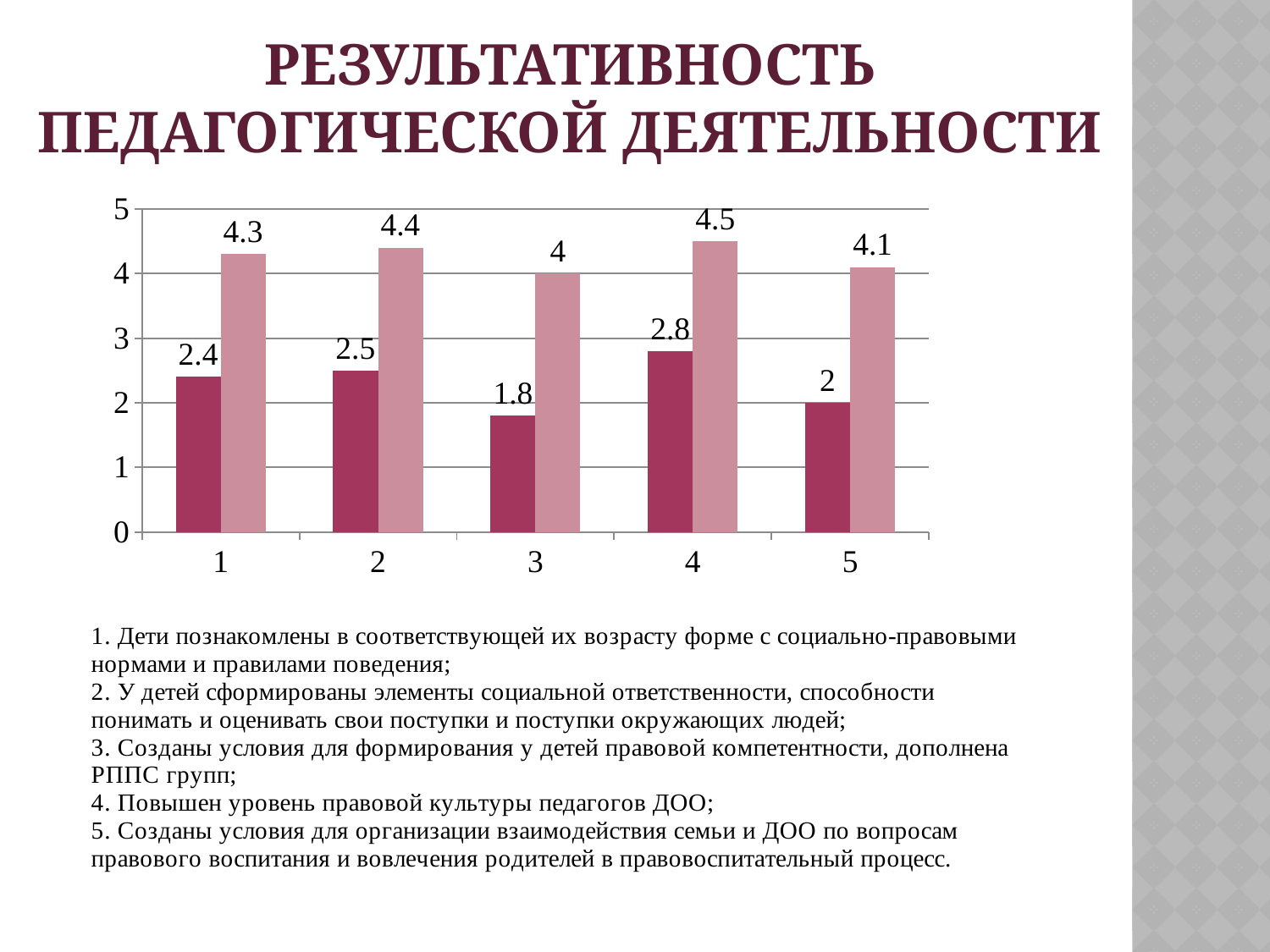
What is the value of the dark magenta bar for category 3? 1.8 Which category has the lowest dark magenta bar? 3 Which is larger: the dark magenta bar for category 2 or the dark magenta bar for category 5? category 2 What is the value of the dark magenta bar for category 5? 2 What kind of chart is shown on the slide? bar chart What is the difference between the dark magenta bars for category 4 and category 3? 1 What is the value of the light pink bar for category 4? 4.5 How many categories are shown on the x axis? 5 What is the title of the slide containing the chart? РЕЗУЛЬТАТИВНОСТЬ ПЕДАГОГИЧЕСКОЙ ДЕЯТЕЛЬНОСТИ Is the light pink bar for category 3 greater or less than 3? greater What is the difference between the light pink and dark magenta bars for category 1? 1.9 Which category has the highest light pink bar? 4